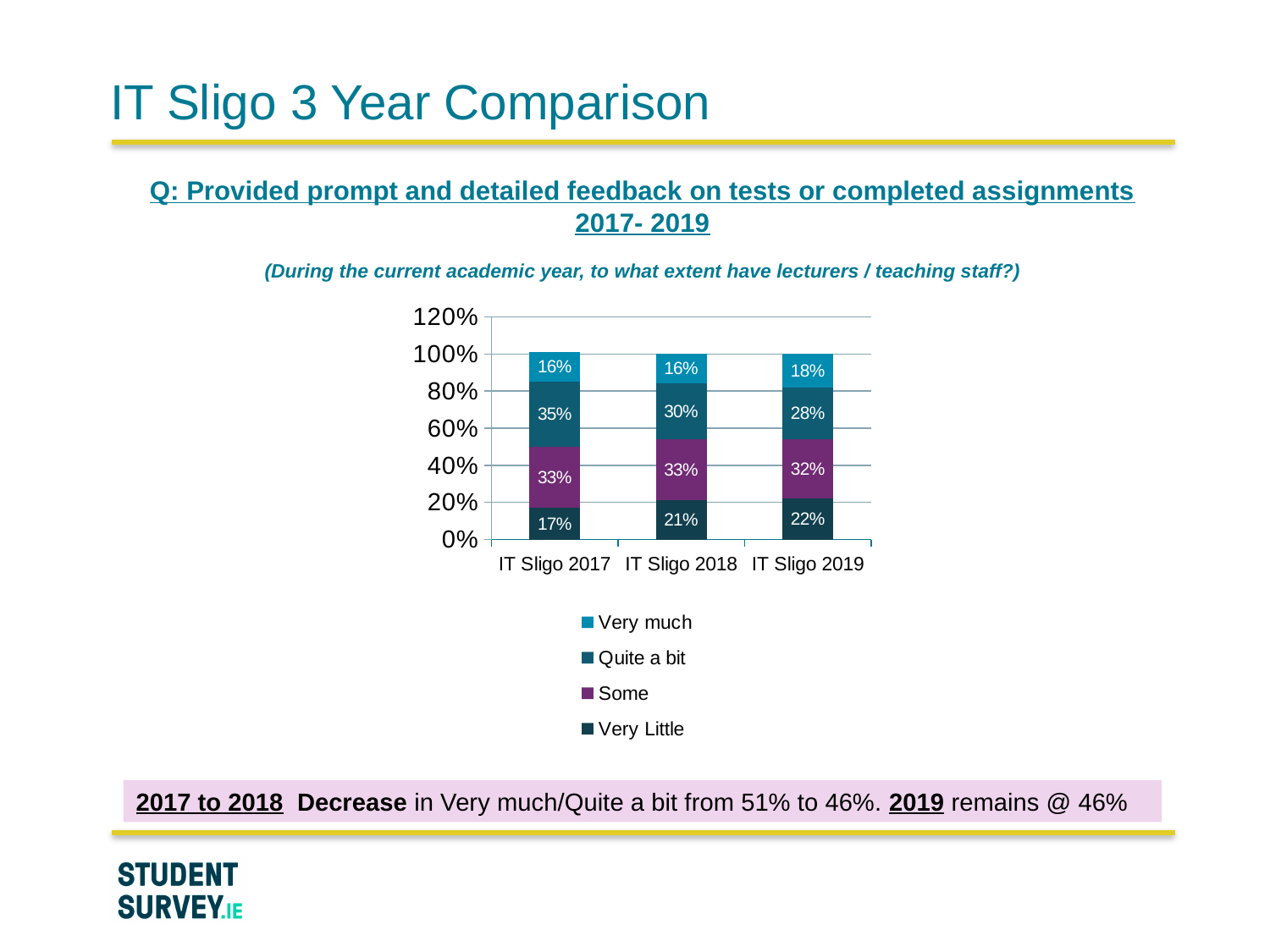
What kind of chart is shown on the slide? Stacked bar chart What is the value for Quite a bit for IT Sligo 2017? 35% Which is larger, the Very Little value for IT Sligo 2017 or for IT Sligo 2018? IT Sligo 2018 What is the value for Some for IT Sligo 2018? 33% Which year has the highest value for Very Little? IT Sligo 2019 How many series does the legend list? 4 What is the value for Very much for IT Sligo 2019? 18% What is the value for Very Little for IT Sligo 2019? 22% How many years (categories) are shown on the x axis? 3 Do the Very Little values rise or fall from IT Sligo 2017 to IT Sligo 2019? Rise What is the difference between the Quite a bit values for IT Sligo 2017 and IT Sligo 2019? 7% Which year has the lowest value for Quite a bit? IT Sligo 2019